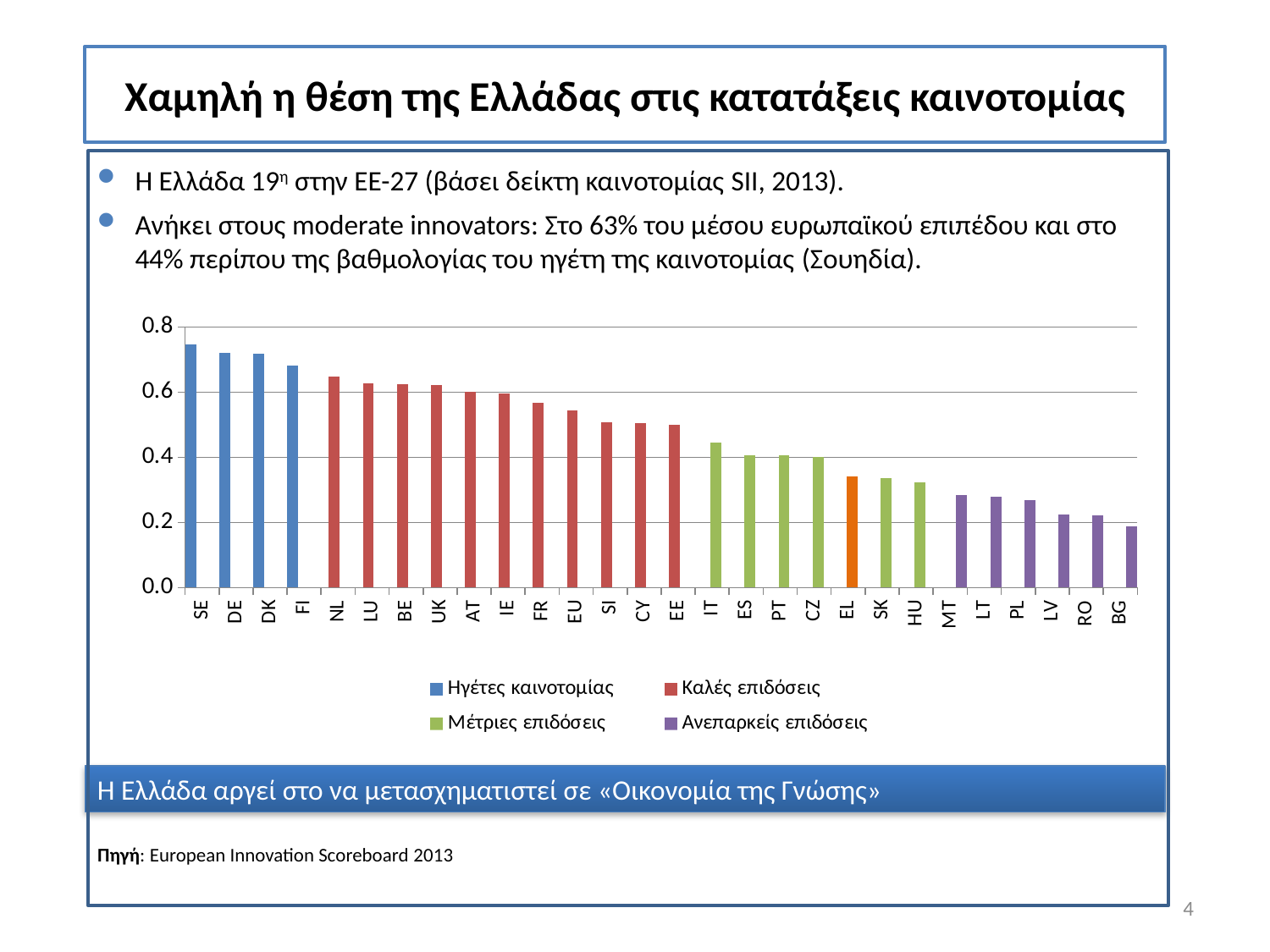
Is the value for MT greater or less than 0.4? less Which category has the highest value in the chart? SE Which has a larger value, DE or EL? DE How many countries/categories are shown on the x axis of the chart? 28 Which category has the lowest value in the chart? BG Is the value for SE greater or less than 0.6? greater What kind of chart is shown on the slide? bar chart Is the value for NL greater or less than 0.6? greater Which legend entry is shown in blue? Ηγέτες καινοτομίας How many series does the chart legend list? 4 Do the values rise or fall moving from left to right along the x axis? fall